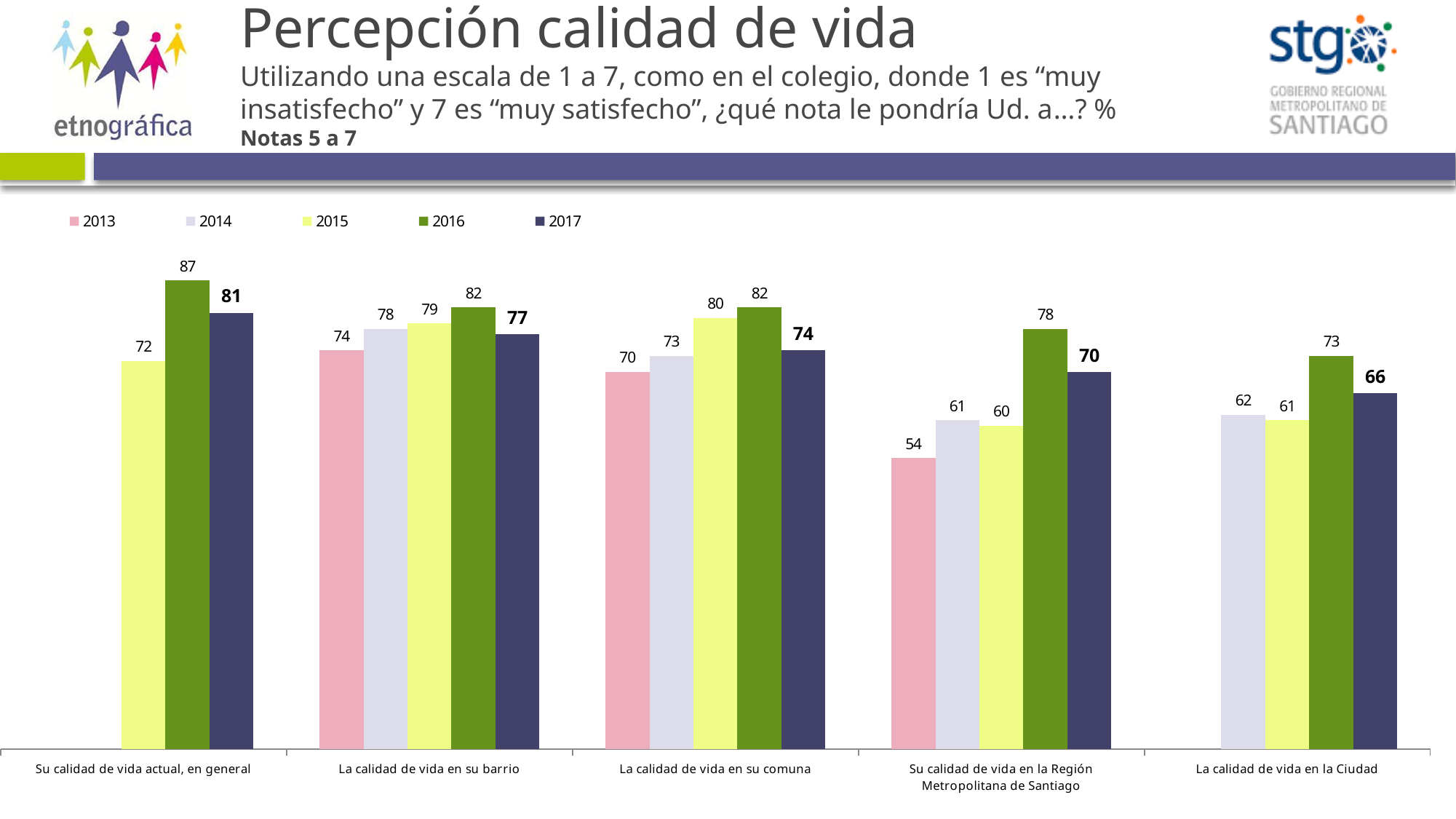
What is the 2014 value for 'La calidad de vida en su comuna'? 73 Which year is shown in dark navy bars in the legend? 2017 What is the 2017 value for 'Su calidad de vida actual, en general'? 81 What is the 2013 value for 'Su calidad de vida en la Región Metropolitana de Santiago'? 54 What kind of chart is shown on the slide? Bar chart What is the 2016 value for 'La calidad de vida en la Ciudad'? 73 Which category has the lowest 2017 value? La calidad de vida en la Ciudad What is the difference between the 2016 and 2017 values for 'Su calidad de vida en la Región Metropolitana de Santiago'? 8 How many series does the legend list? 5 How many categories are shown on the x axis? 5 Which category has the highest 2016 value? Su calidad de vida actual, en general Which is larger for 'La calidad de vida en su barrio': the 2015 value or the 2017 value? 2015